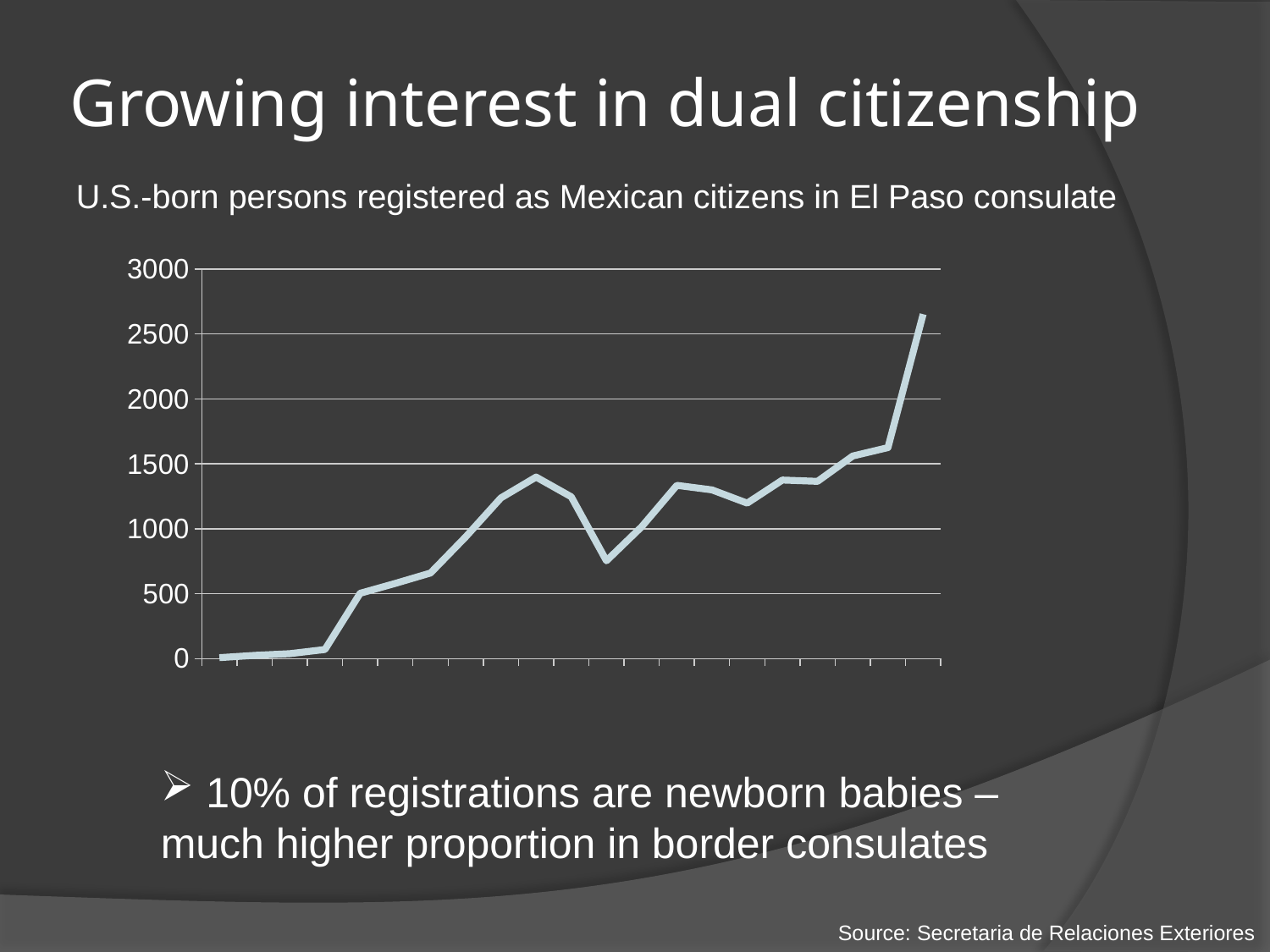
Where along the x axis does the line reach its lowest value? at the first (leftmost) point What kind of chart is shown on the slide? line chart Is the value at the sharp dip in the middle of the line greater or less than 1000? less What is the maximum value shown on the y axis? 3000 Overall, do the values in the chart rise or fall from left to right along the x axis? rise What is the subtitle describing the data plotted in the chart? U.S.-born persons registered as Mexican citizens in El Paso consulate Is the value of the first (leftmost) point on the line greater or less than 500? less Is the value of the last (rightmost) point on the line greater or less than 2500? greater Where along the x axis does the line reach its highest value? at the last (rightmost) point Which point on the line has the highest value, the first point or the last point? the last point What source is cited for the chart data? Secretaria de Relaciones Exteriores